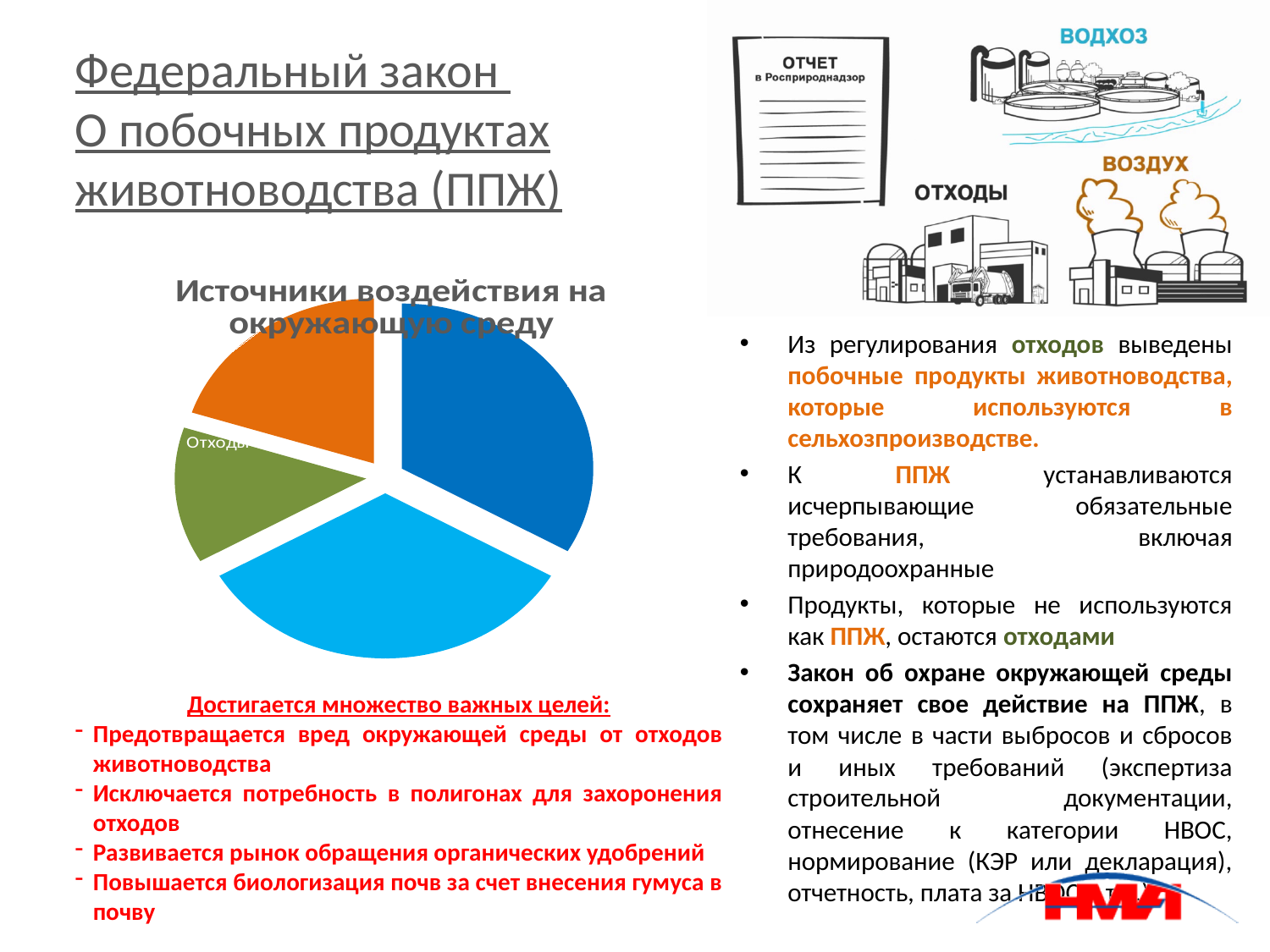
Is the slice labelled "Отходы" the largest or the smallest slice of the pie chart? smallest What is the title of the pie chart? Источники воздействия на окружающую среду What kind of chart is shown on the slide? pie chart What colour is the slice labelled "Отходы" in the pie chart? green How many slices does the pie chart have? 4